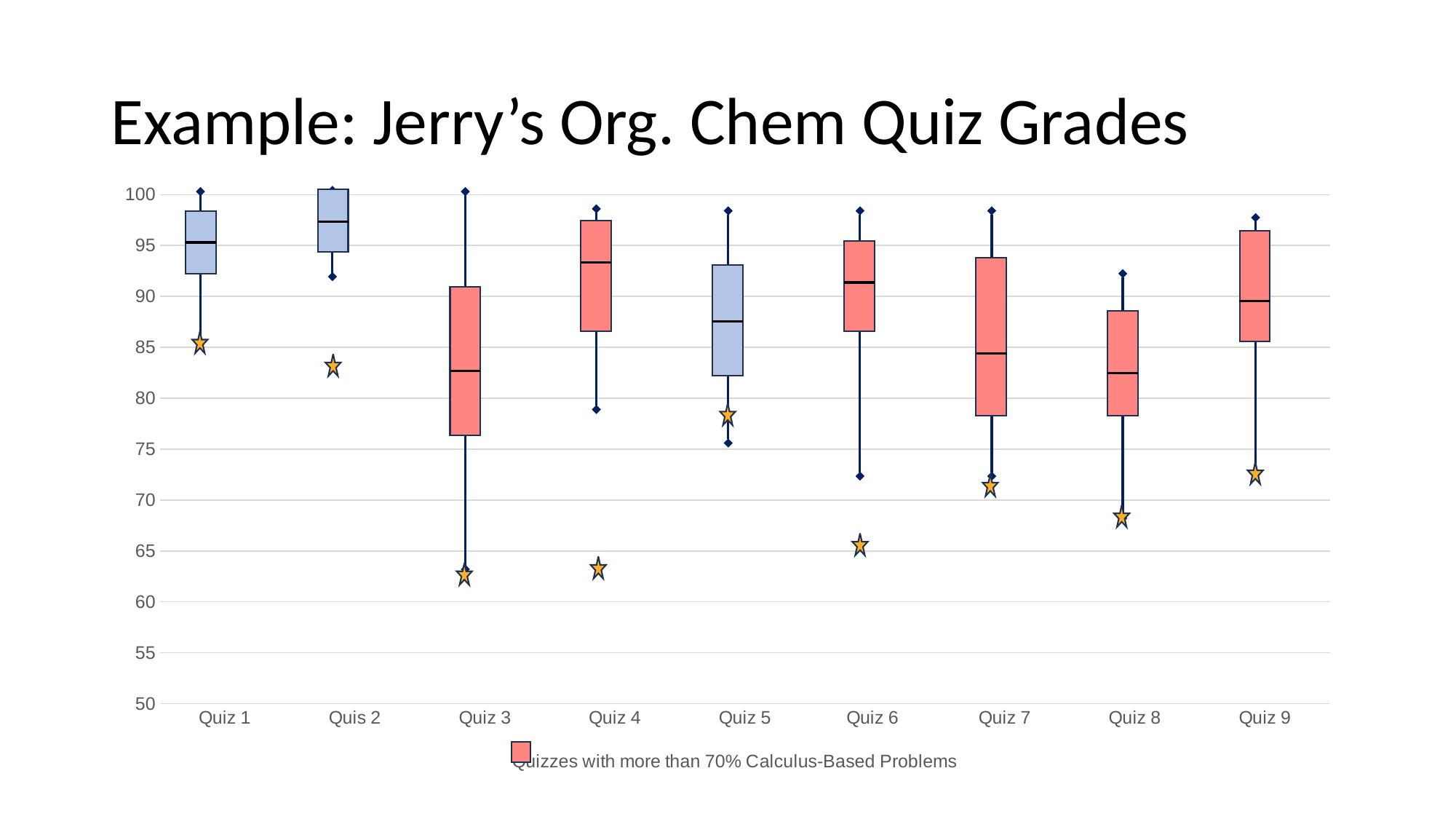
How many quizzes are drawn with red boxes? 6 Which quiz has the highest star marker? Quiz 1 Is the median for Quiz 3 greater or less than 85? less Is the star marker for Quiz 4 greater or less than 65? less How many quizzes are shown along the x axis? 9 Which has the higher median, Quiz 4 or Quiz 8? Quiz 4 How many entries does the legend list? 1 Is the star marker for Quiz 8 greater or less than 70? less What does the legend entry say the red boxes represent? Quizzes with more than 70% Calculus-Based Problems Which quiz has the highest median line? Quis 2 What kind of chart is shown on the slide? Box-and-whisker chart